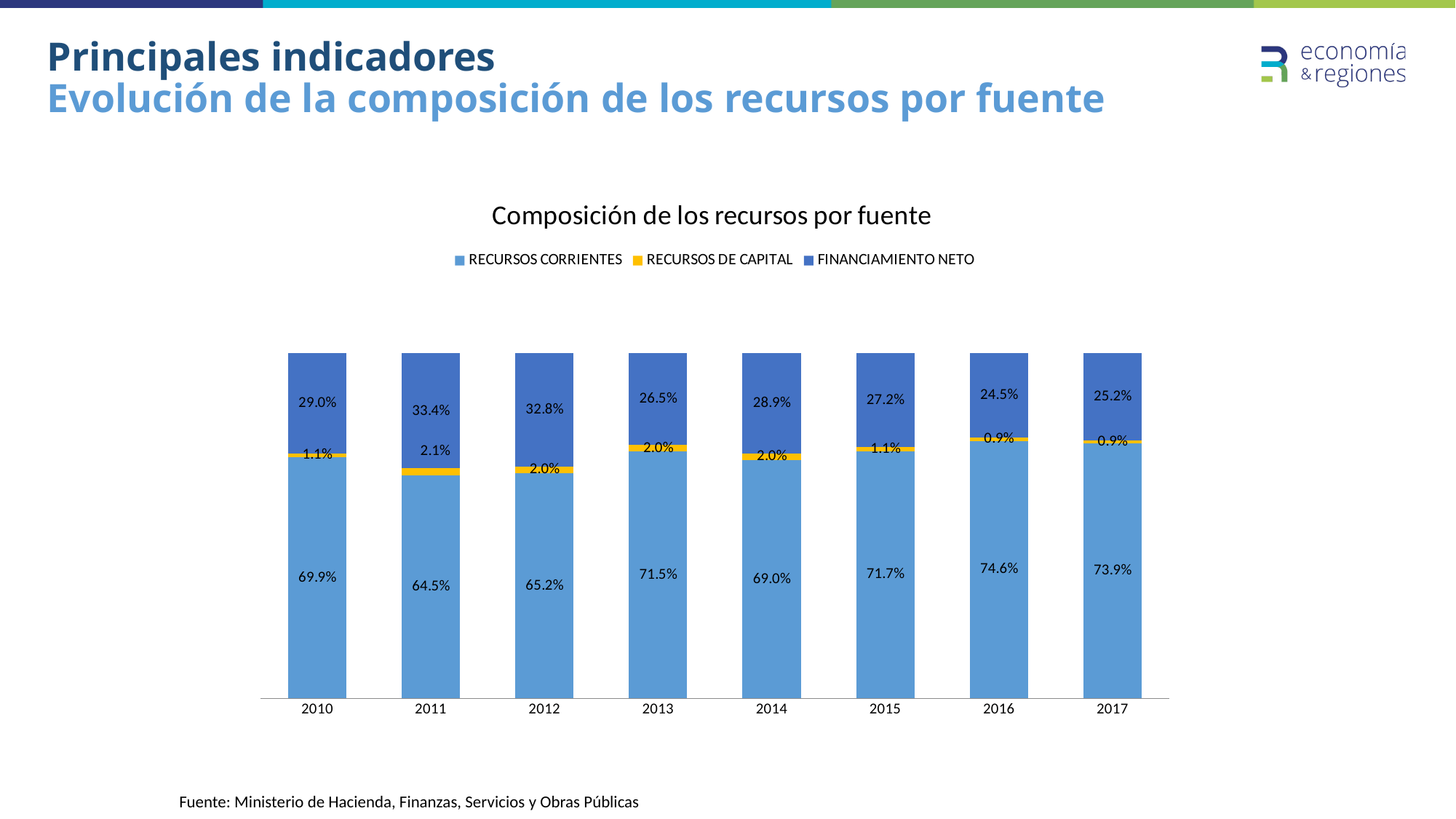
What is the value of RECURSOS CORRIENTES in 2013? 71.5% In which year is RECURSOS CORRIENTES lowest? 2011 How many years are shown on the x axis? 8 Which is larger: FINANCIAMIENTO NETO in 2012 or in 2017? 2012 What is the title of the chart? Composición de los recursos por fuente What is the value of RECURSOS DE CAPITAL in 2016? 0.9% What is the difference between RECURSOS CORRIENTES in 2016 and in 2011? 10.1 percentage points What type of chart is shown on the slide? Stacked bar chart In which year is FINANCIAMIENTO NETO lowest? 2016 What is the value of FINANCIAMIENTO NETO in 2011? 33.4% In which year is RECURSOS CORRIENTES highest? 2016 How many series does the legend list? 3